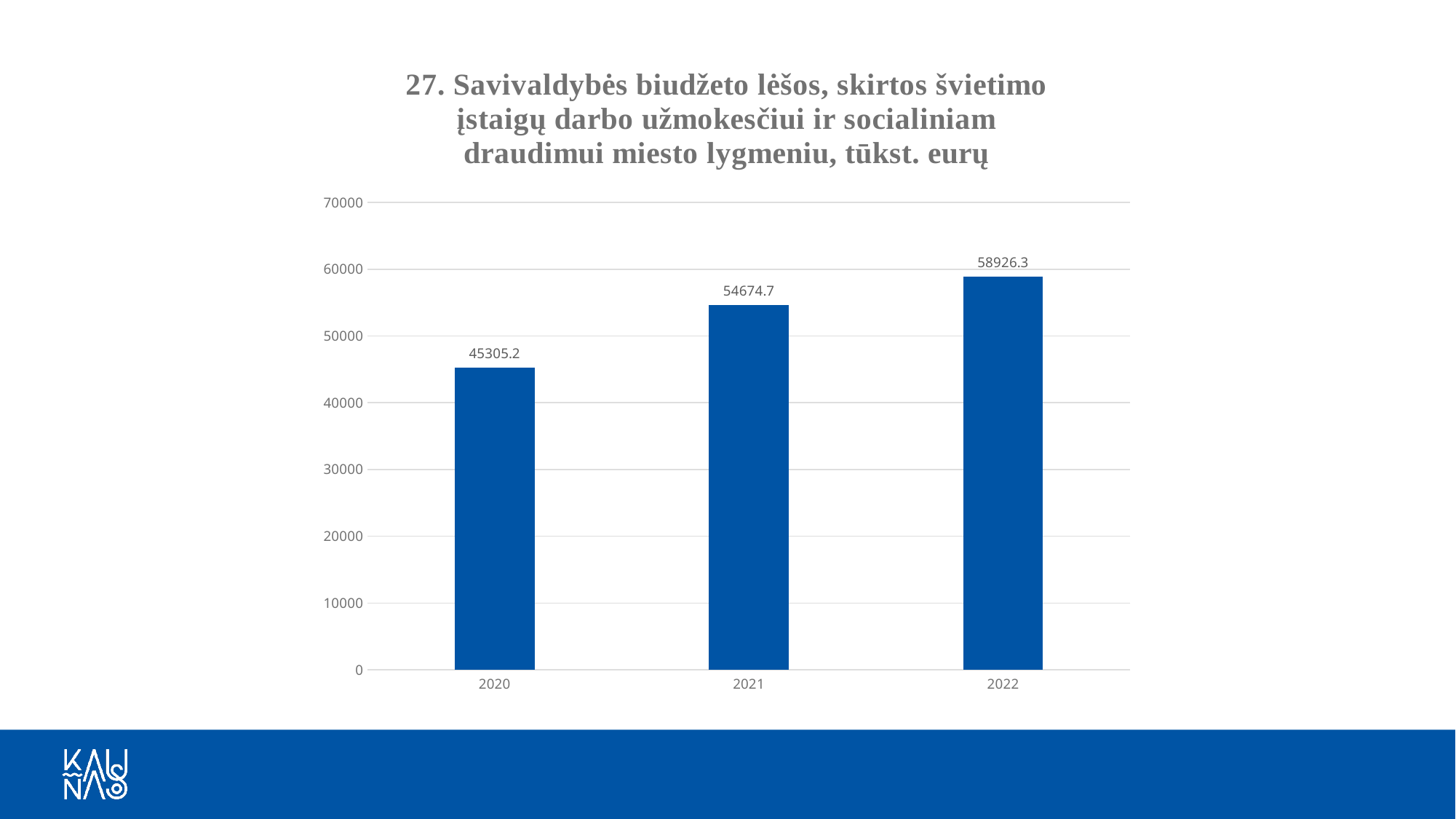
Which year has the highest value? 2022 What is the difference between the values for 2022 and 2021? 4251.6 Which is larger, the value for 2020 or the value for 2021? 2021 What is the difference between the values for 2021 and 2020? 9369.5 What kind of chart is shown on the slide? bar chart Do the values rise or fall from 2020 to 2022? rise Is the value for 2020 greater or less than 50000? less Which year has the lowest value? 2020 What is the value for 2020? 45305.2 How many years are shown on the chart? 3 What is the value for 2021? 54674.7 What is the value for 2022? 58926.3